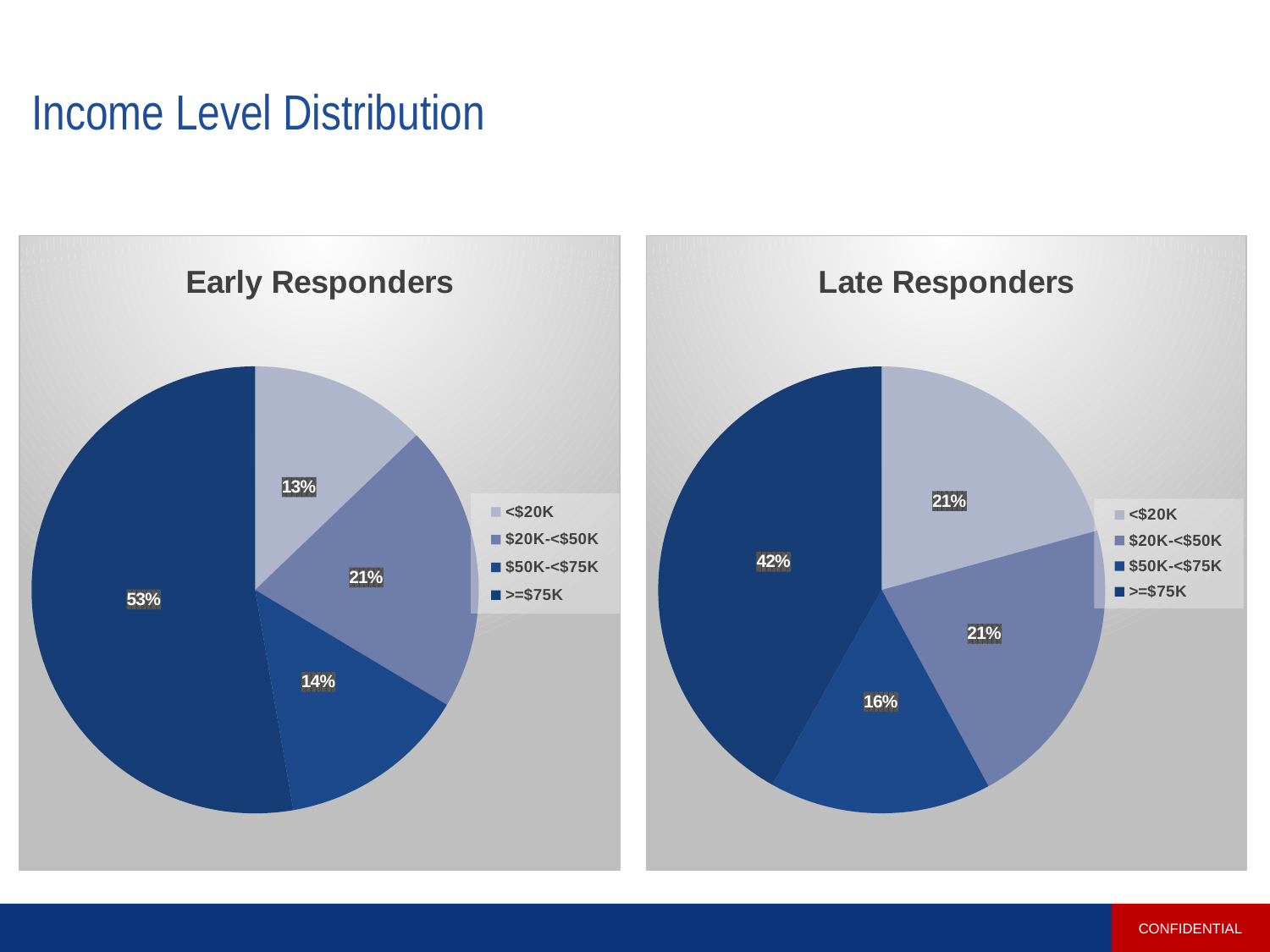
In the Early Responders chart, what share of responders have income <$20K? 13% What is the title of the chart on the left side of the slide? Early Responders In the Late Responders chart, which income level has the smallest share? $50K-<$75K In the Early Responders chart, which income level has the smallest share? <$20K How many income level categories does the Early Responders chart show? 4 In the Early Responders chart, what share of responders have income >=$75K? 53% Which chart shows a larger share for <$20K, Early Responders or Late Responders? Late Responders In the Late Responders chart, what share of responders have income $50K-<$75K? 16% What type of chart is the Late Responders chart? Pie chart In the Early Responders chart, which income level has the largest share? >=$75K What is the difference between the >=$75K share in the Early Responders chart and the >=$75K share in the Late Responders chart? 11 percentage points In the Late Responders chart, what share of responders have income >=$75K? 42%